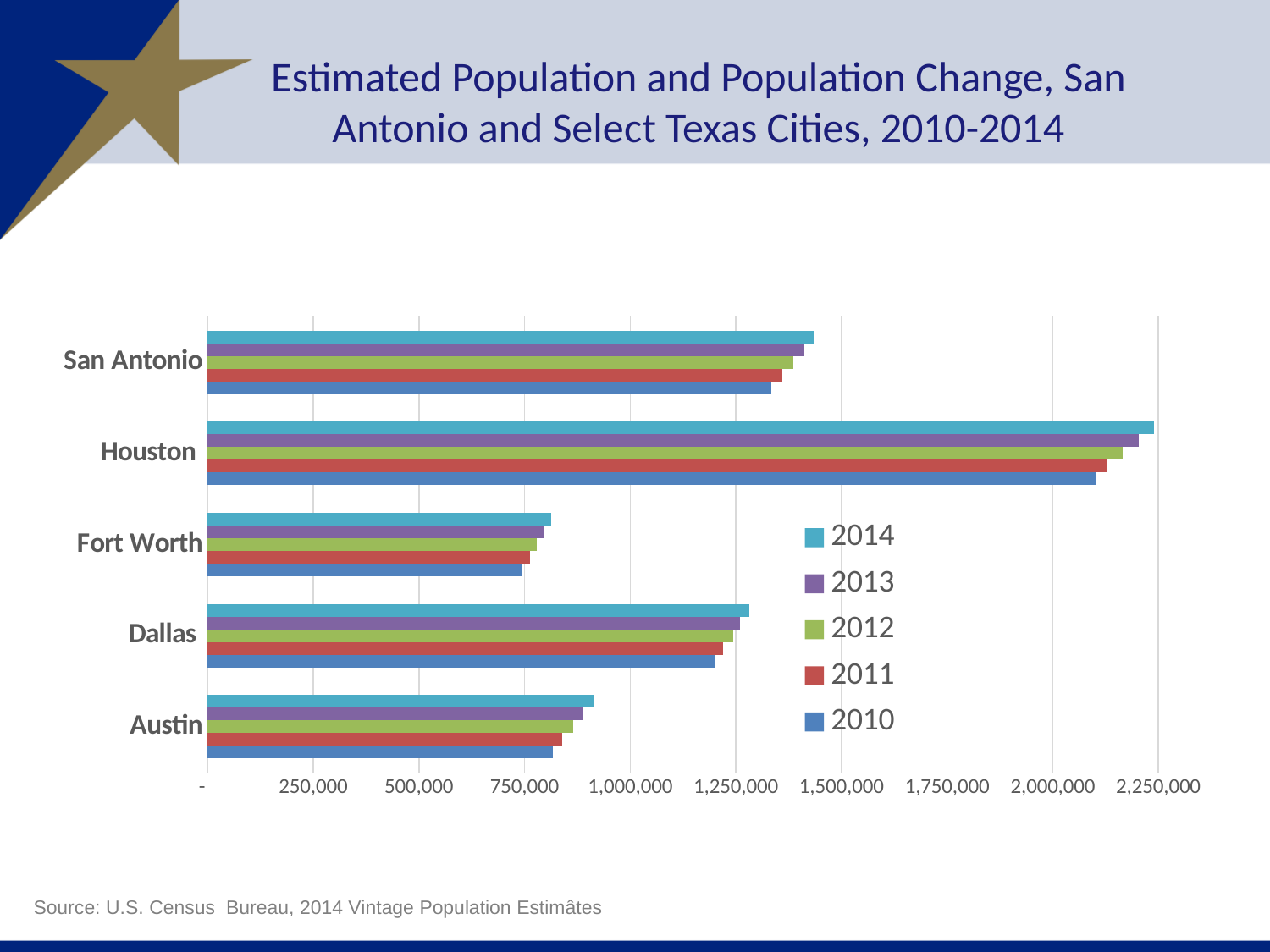
Which city has the highest estimated population in 2014? Houston Which year does the legend list first (at the top)? 2014 Is the 2014 value for Houston greater or less than 2,000,000? greater Is the 2014 value for Austin greater or less than 1,000,000? less What kind of chart is shown on the slide? Bar chart Is the 2010 value for San Antonio greater or less than 1,250,000? greater How many series does the legend list? 5 From 2010 to 2014, does the estimated population for Austin rise or fall? Rise Which city has the lowest estimated population in 2014? Fort Worth How many cities are shown on the chart? 5 Which is larger, the 2014 value for San Antonio or the 2014 value for Dallas? San Antonio